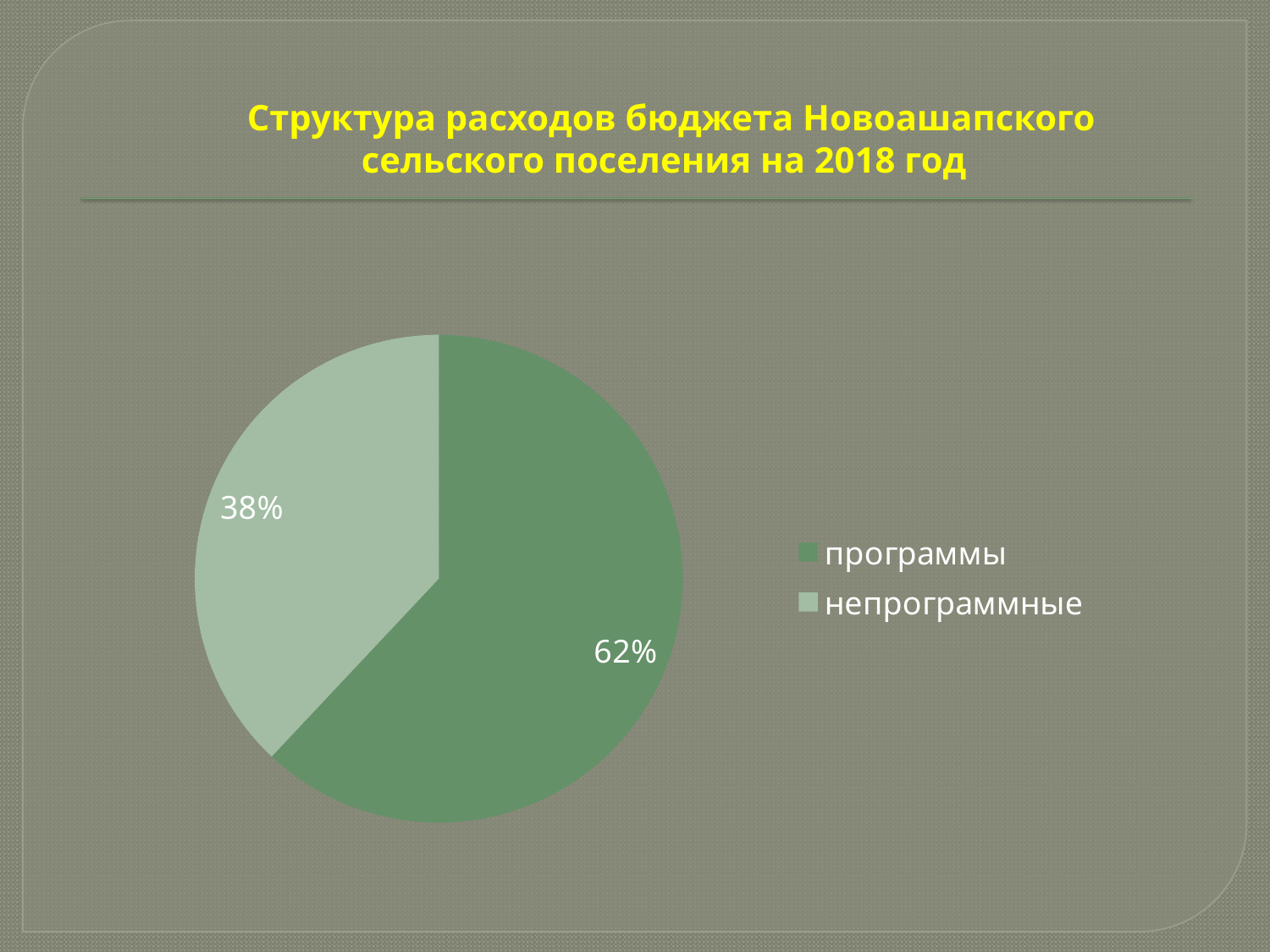
Which legend entry is shown in the lighter green colour? непрограммные How many entries does the legend list? 2 What share of the pie does "программы" take? 62% Which is larger: the share for "программы" or for "непрограммные"? программы What is the title of the slide containing the chart? Структура расходов бюджета Новоашапского сельского поселения на 2018 год Which category has the largest share of the pie? программы What is the difference in percentage points between the "программы" and "непрограммные" slices? 24 Which category has the smallest share of the pie? непрограммные What kind of chart is shown on the slide? pie chart What share of the pie does "непрограммные" take? 38% How many slices does the pie chart have? 2